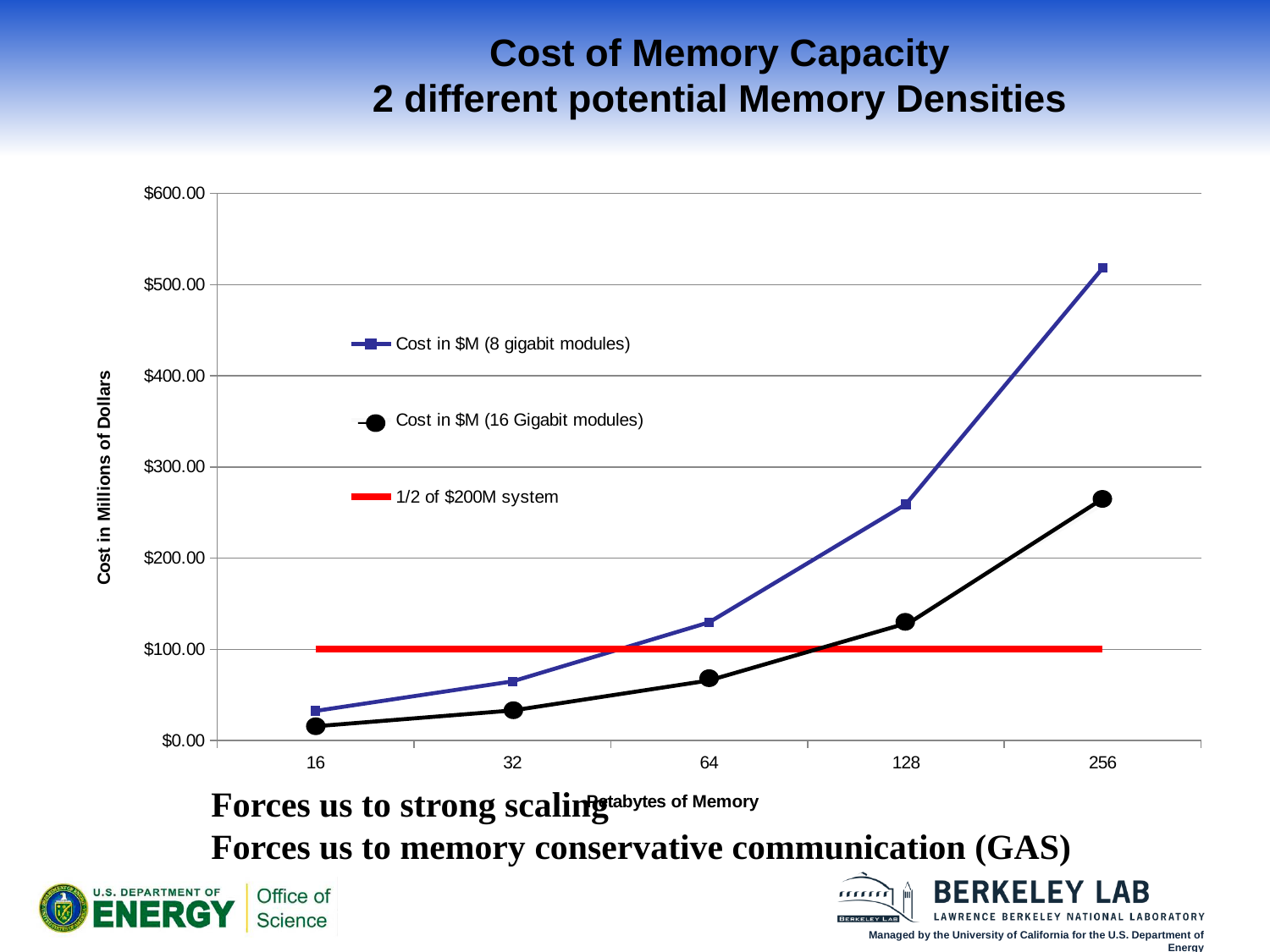
What is the label of the y axis? Cost in Millions of Dollars At which Petabytes of Memory value is Cost in $M (16 Gigabit modules) lowest? 16 How many series does the legend list? 3 At 128 Petabytes of Memory, which series has the higher cost: 8 gigabit modules or 16 Gigabit modules? Cost in $M (8 gigabit modules) Do the costs for the 8 gigabit modules series rise or fall as Petabytes of Memory increases? rise How many Petabytes of Memory values are marked on the x axis? 5 What kind of chart is shown on the slide? line chart Is the value for Cost in $M (8 gigabit modules) at 128 Petabytes greater or less than $200.00? greater Is the value for Cost in $M (8 gigabit modules) at 256 Petabytes greater or less than $400.00? greater Is the value for Cost in $M (16 Gigabit modules) at 256 Petabytes greater or less than $200.00? greater At which Petabytes of Memory value is Cost in $M (8 gigabit modules) highest? 256